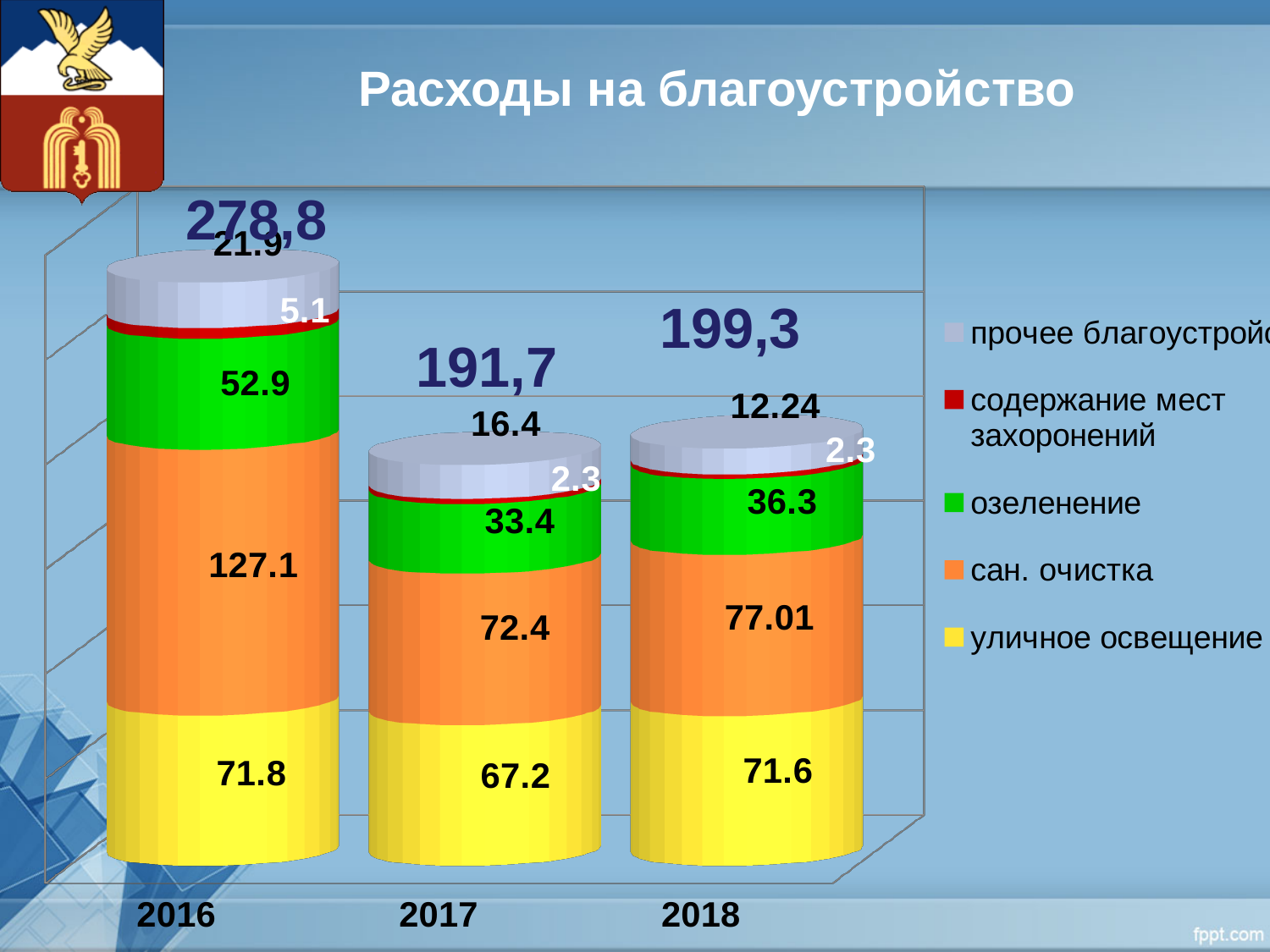
What is the value for уличное освещение in 2017? 67.2 Which year has the highest value for сан. очистка? 2016 Which year has the lowest value for озеленение? 2017 What is the difference between the сан. очистка values for 2016 and 2017? 54.7 How many years are shown on the x axis? 3 What kind of chart is shown on the slide? Stacked bar chart What is the value for сан. очистка in 2016? 127.1 What is the value for содержание мест захоронений in 2016? 5.1 What is the total shown above the 2017 bar? 191,7 What is the value for озеленение in 2018? 36.3 Which is larger: уличное освещение in 2016 or in 2018? 2016 How many series does the legend list? 5